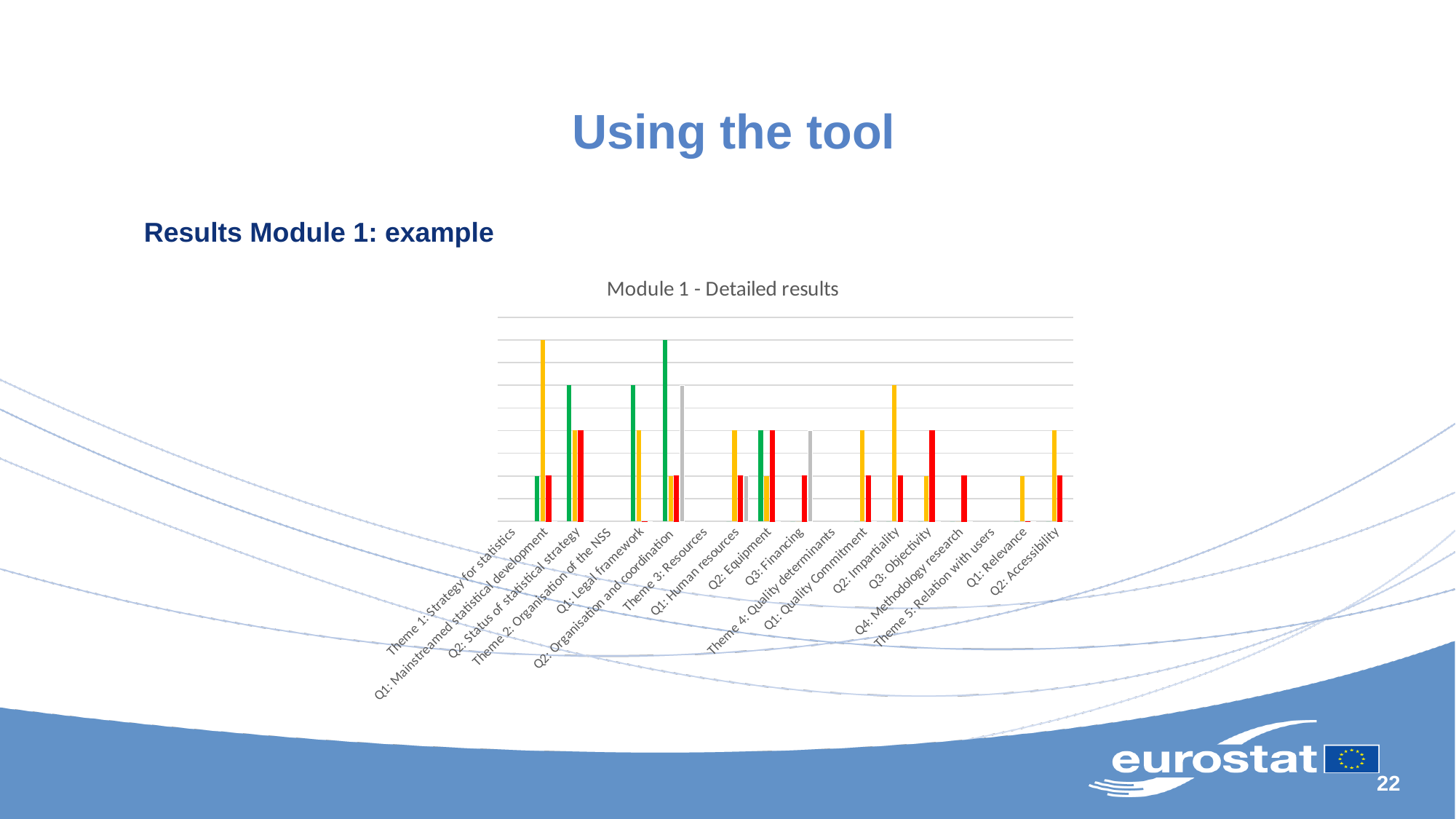
Which has the taller yellow bar: Q1: Mainstreamed statistical development or Q1: Relevance? Q1: Mainstreamed statistical development How many categories are listed along the x axis of the chart? 18 What kind of chart is shown on the slide? bar chart What is the title of the chart? Module 1 - Detailed results Which has the taller red bar: Q3: Objectivity or Q4: Methodology research? Q3: Objectivity What colour is the tallest bar in the Q2: Organisation and coordination category? green Which has the taller grey bar: Q2: Organisation and coordination or Q1: Human resources? Q2: Organisation and coordination